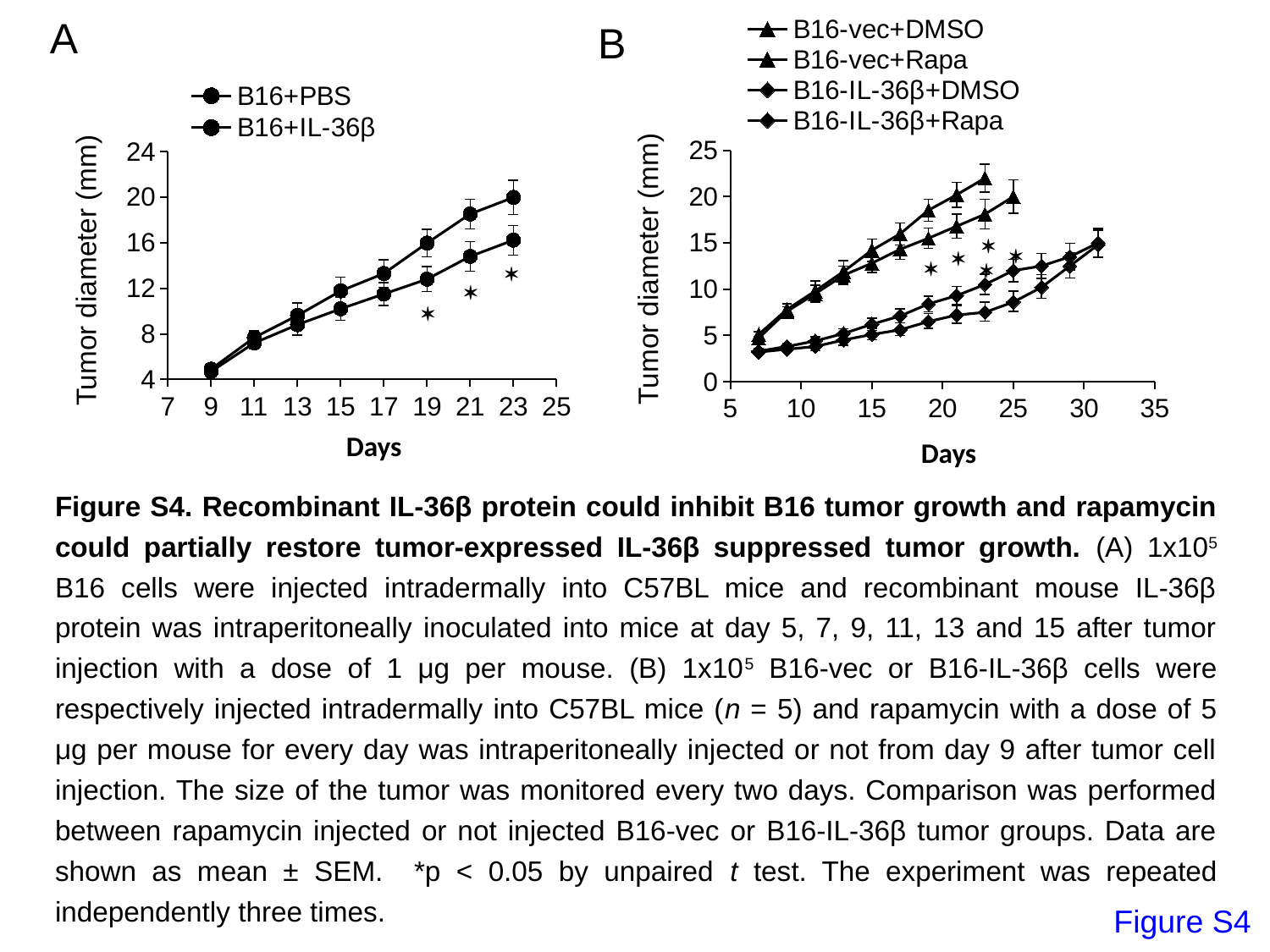
In chart B on the right, is the value for B16-vec+DMSO at day 23 greater or less than 20? greater What kind of chart is chart A on the left? line chart In chart B on the right, do the values for B16-vec+DMSO rise or fall as the days increase? rise In chart B on the right, which series has the larger tumor diameter at day 21, B16-vec+DMSO or B16-IL-36β+DMSO? B16-vec+DMSO In chart A on the left, is the value for B16+IL-36β at day 19 greater or less than 16? less What is the y-axis label of chart B on the right? Tumor diameter (mm) How many series does the legend of chart B on the right list? 4 In chart A on the left, is the value for B16+PBS at day 23 greater or less than 16? greater In chart A on the left, how many time points are plotted for the B16+PBS series? 8 How many series does the legend of chart A on the left list? 2 In chart A on the left, which series has the larger tumor diameter at day 23, B16+PBS or B16+IL-36β? B16+PBS